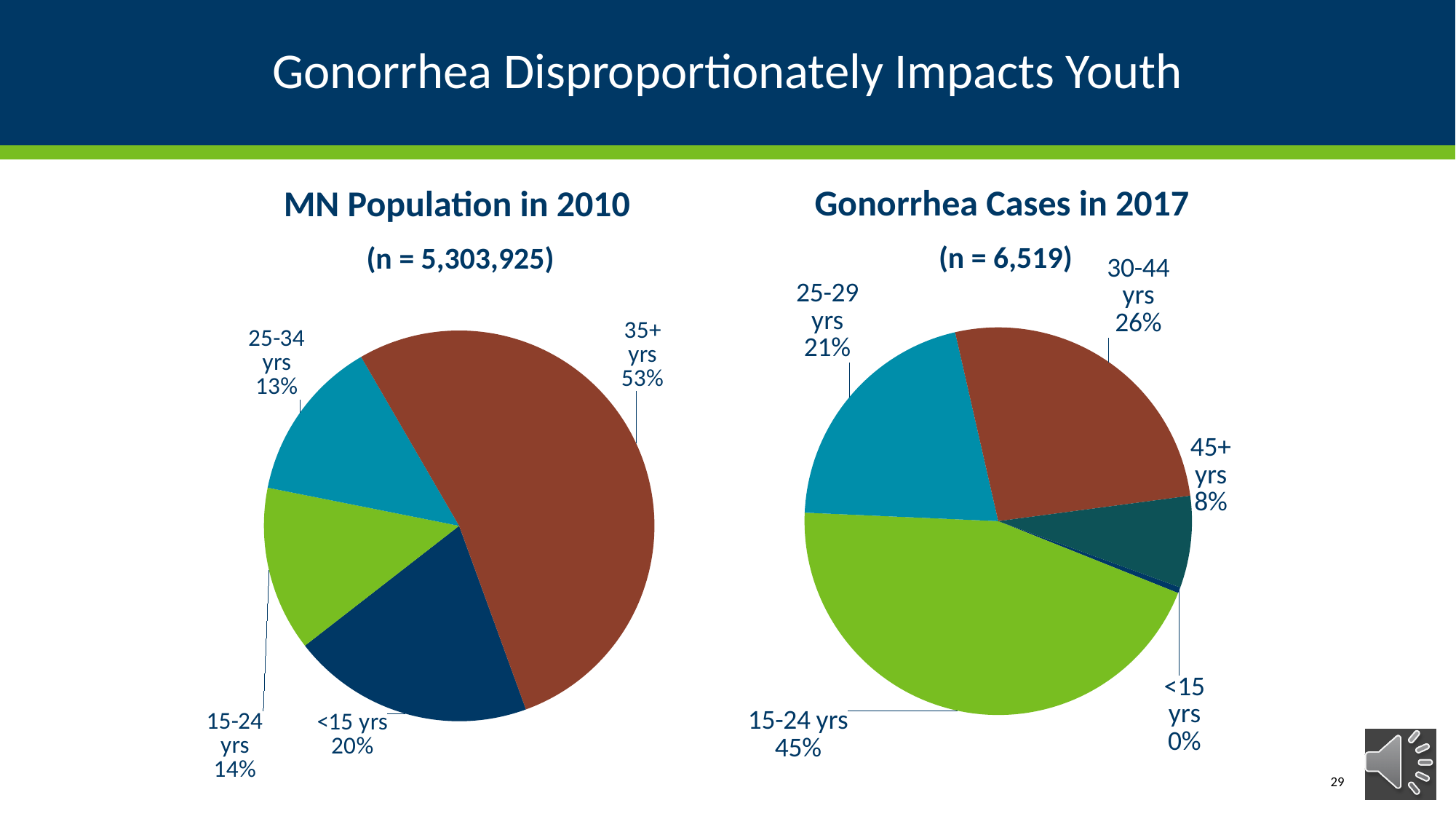
What type of chart is the 'MN Population in 2010' chart? Pie chart In the 'Gonorrhea Cases in 2017' chart, which age group has the smallest share? <15 yrs In the 'Gonorrhea Cases in 2017' chart, what share of cases is 15-24 yrs? 45% In the 'Gonorrhea Cases in 2017' chart, what share of cases is 45+ yrs? 8% In the 'MN Population in 2010' chart, what share of the population is 35+ yrs? 53% In the 'Gonorrhea Cases in 2017' chart, which age group has the largest share? 15-24 yrs In the 'MN Population in 2010' chart, which age group has the smallest share? 25-34 yrs In the 'MN Population in 2010' chart, what share of the population is 25-34 yrs? 13% What is the difference between the 15-24 yrs share in the 'Gonorrhea Cases in 2017' chart and the 15-24 yrs share in the 'MN Population in 2010' chart? 31 percentage points In the 'MN Population in 2010' chart, which is larger: the share for <15 yrs or the share for 15-24 yrs? <15 yrs How many age groups are shown in the 'Gonorrhea Cases in 2017' chart? 5 What is the sample size (n) shown for the 'Gonorrhea Cases in 2017' chart? 6,519